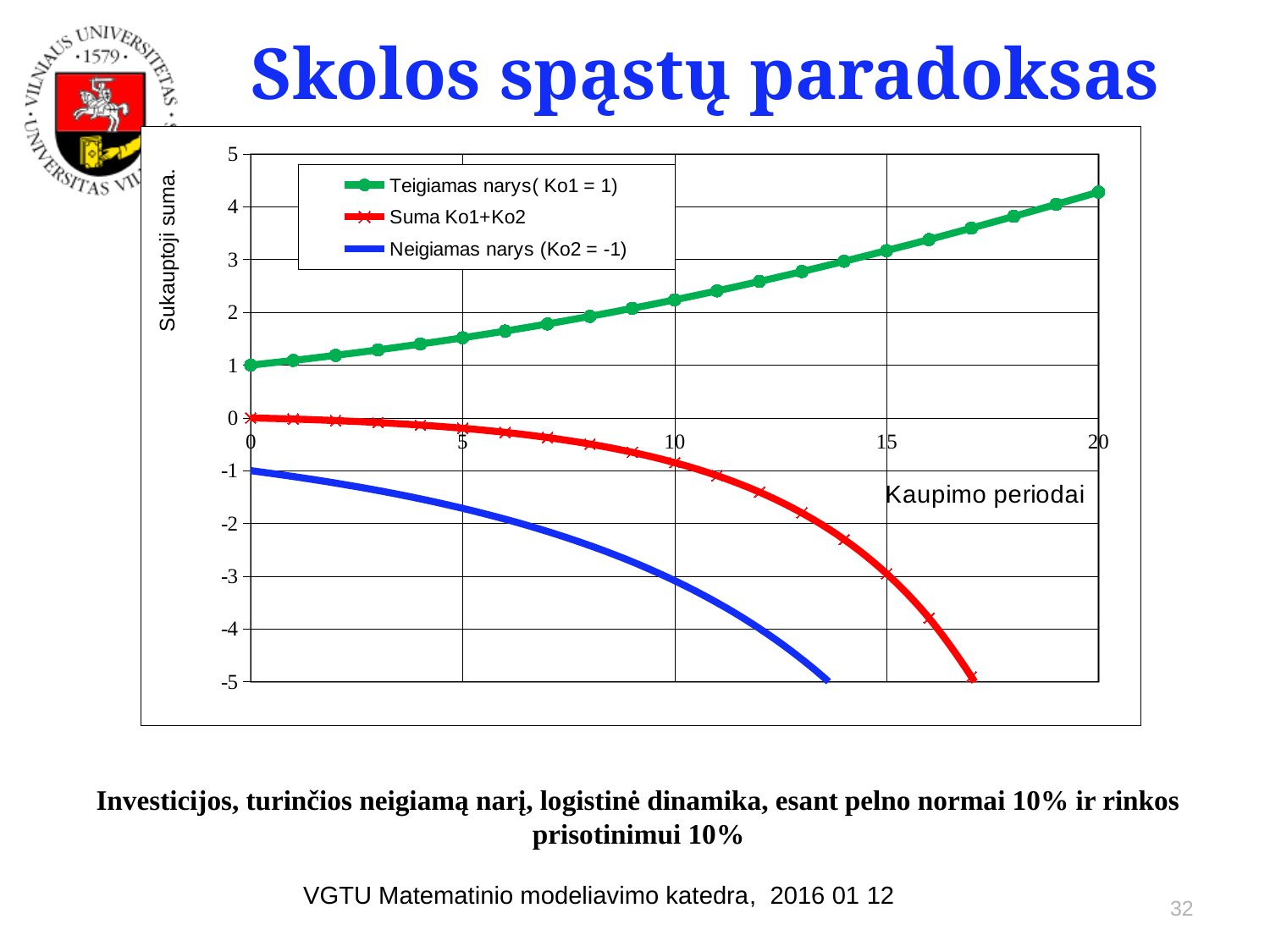
Does the Neigiamas narys (Ko2 = -1) series rise or fall as the number of periods increases? fall What kind of chart is shown on the slide? line chart What is the value of Neigiamas narys (Ko2 = -1) at period 0? -1 How many series does the legend list? 3 Is the value of Teigiamas narys (Ko1 = 1) at period 20 greater or less than 4? greater What is the value of Teigiamas narys (Ko1 = 1) at period 0? 1 Which series is higher at period 10: Teigiamas narys (Ko1 = 1) or Suma Ko1+Ko2? Teigiamas narys (Ko1 = 1) Is the value of Neigiamas narys (Ko2 = -1) at period 10 greater or less than -2? less What is the value of Suma Ko1+Ko2 at period 0? 0 Is the value of Suma Ko1+Ko2 at period 15 greater or less than -2? less What is the label of the x axis? Kaupimo periodai Does the Teigiamas narys (Ko1 = 1) series rise or fall as the number of periods increases? rise